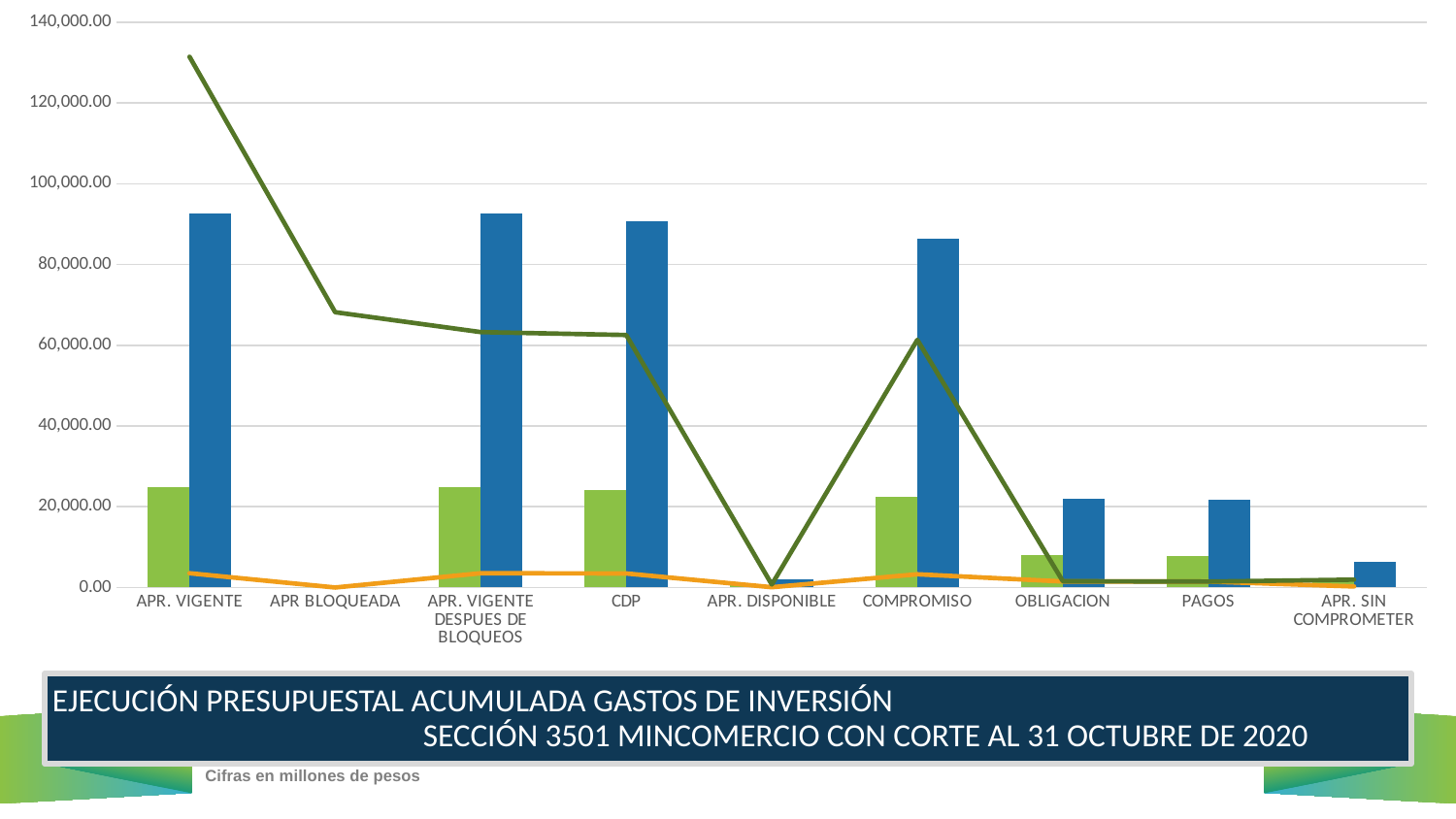
Is the blue bar for APR. SIN COMPROMETER greater or less than 20,000.00? less What kind of chart is shown on the slide? A combination chart of bars and lines Which category has the lowest blue bar among those with a blue bar? APR. DISPONIBLE According to the note below the chart, in what units are the figures expressed? Millones de pesos Is the dark green line value for APR. VIGENTE greater or less than 120,000.00? greater How many categories are shown on the x axis of the chart? 9 Is the blue bar for OBLIGACION greater or less than 20,000.00? greater Which blue bar is taller, CDP or COMPROMISO? CDP Which category has the highest value on the dark green line? APR. VIGENTE